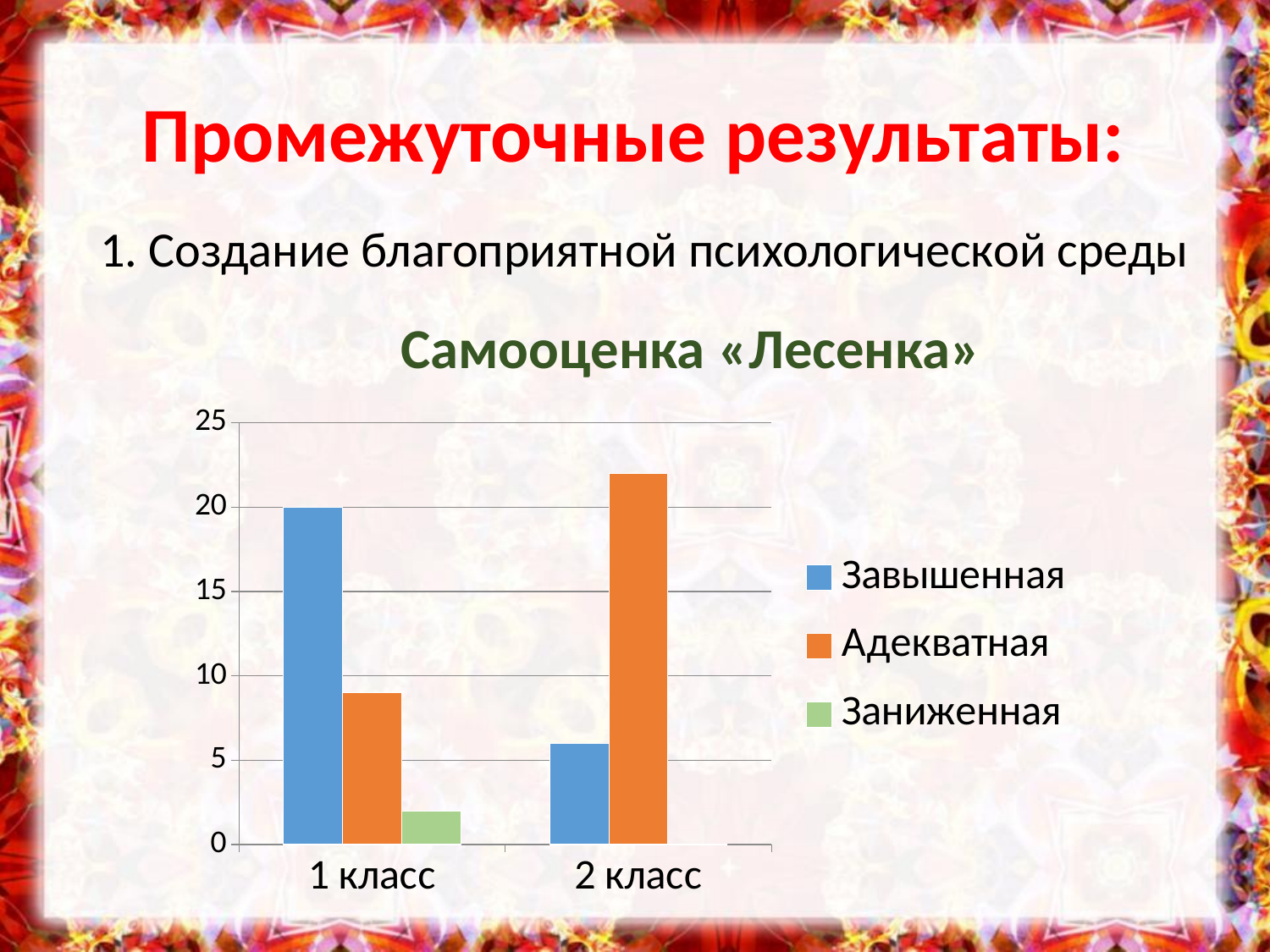
Which series has the lowest value in 1 класс? Заниженная How many categories are shown on the x axis? 2 Is the value for Адекватная in 2 класс greater or less than 20? greater Is the value for Адекватная in 1 класс greater or less than 10? less Is the value for Заниженная in 1 класс greater or less than 5? less Which series has the highest value in 2 класс? Адекватная What is the title of the chart? Самооценка «Лесенка» How many series does the legend list? 3 Which is larger: Завышенная in 1 класс or Завышенная in 2 класс? Завышенная in 1 класс What kind of chart is shown on the slide? bar chart What is the value for Завышенная in 1 класс? 20